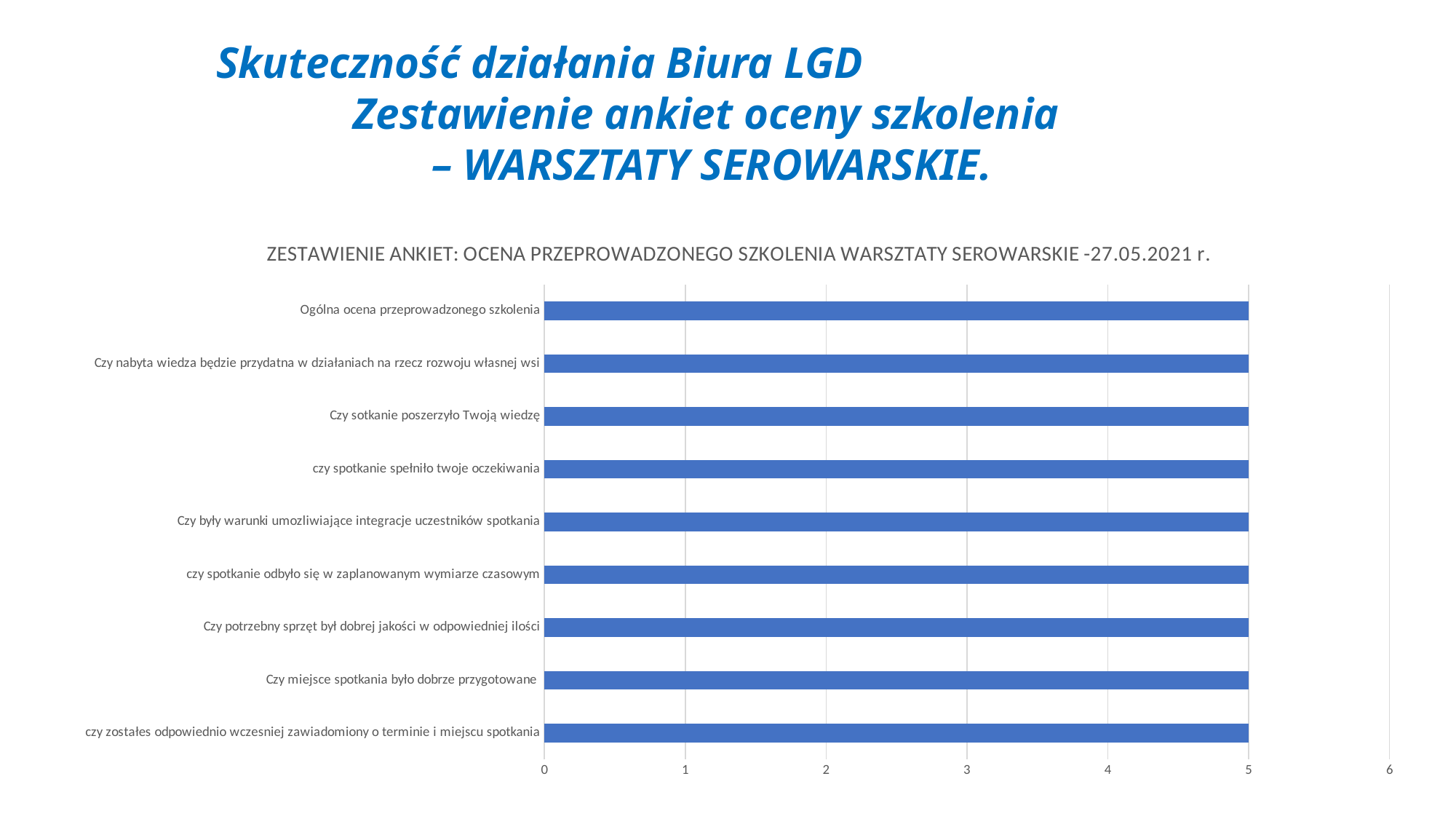
What is the value for "czy zostałes odpowiednio wczesniej zawiadomiony o terminie i miejscu spotkania"? 5 What is the value for "Czy miejsce spotkania było dobrze przygotowane"? 5 What is the difference between the value for "Ogólna ocena przeprowadzonego szkolenia" and the value for "Czy były warunki umozliwiające integracje uczestników spotkania"? 0 What is the highest value shown on the horizontal axis of the chart? 6 How many categories (questions) are plotted in the chart? 9 What is the title of the chart? ZESTAWIENIE ANKIET: OCENA PRZEPROWADZONEGO SZKOLENIA WARSZTATY SEROWARSKIE -27.05.2021 r. What is the value for "Ogólna ocena przeprowadzonego szkolenia"? 5 Is the value for "czy spotkanie odbyło się w zaplanowanym wymiarze czasowym" greater or less than 6? less What kind of chart is shown on the slide? bar chart Is the value for "Czy potrzebny sprzęt był dobrej jakości w odpowiedniej ilości" greater or less than 4? greater What is the value for "Czy sotkanie poszerzyło Twoją wiedzę"? 5 What is the value for "czy spotkanie spełniło twoje oczekiwania"? 5